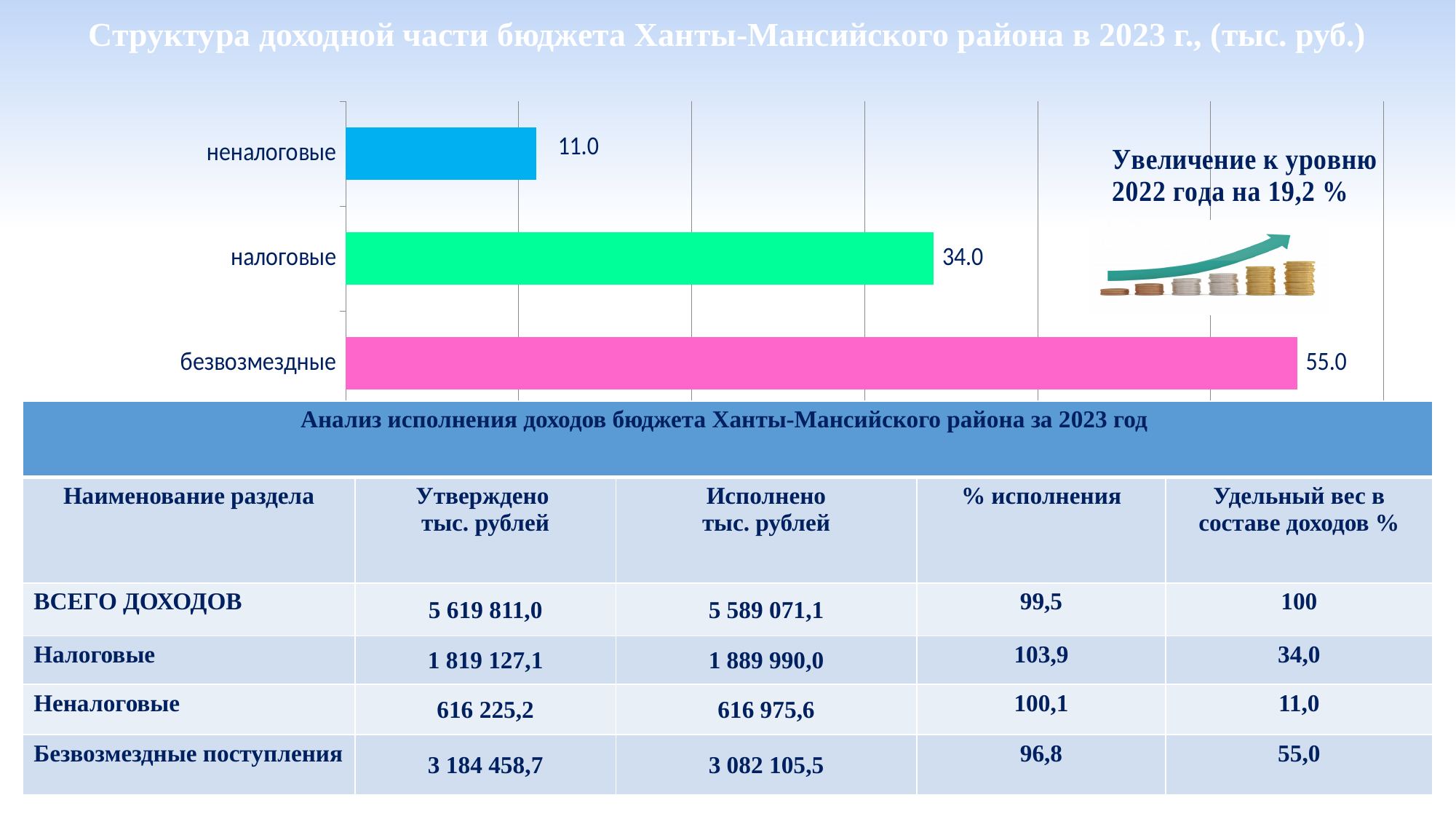
What is the value shown for безвозмездные in the bar chart? 55.0 What is the difference between the values for безвозмездные and налоговые in the bar chart? 21.0 What is the value shown for налоговые in the bar chart? 34.0 Which category has the lowest value in the bar chart? неналоговые What is the difference between the values for налоговые and неналоговые in the bar chart? 23.0 What is the title of the chart on the slide? Структура доходной части бюджета Ханты-Мансийского района в 2023 г., (тыс. руб.) Which category has the highest value in the bar chart? безвозмездные Which is larger in the bar chart, the value for налоговые or the value for неналоговые? налоговые What is the total of the three values shown in the bar chart? 100.0 How many categories are shown in the bar chart? 3 What type of chart is shown on the slide? bar chart What is the value shown for неналоговые in the bar chart? 11.0